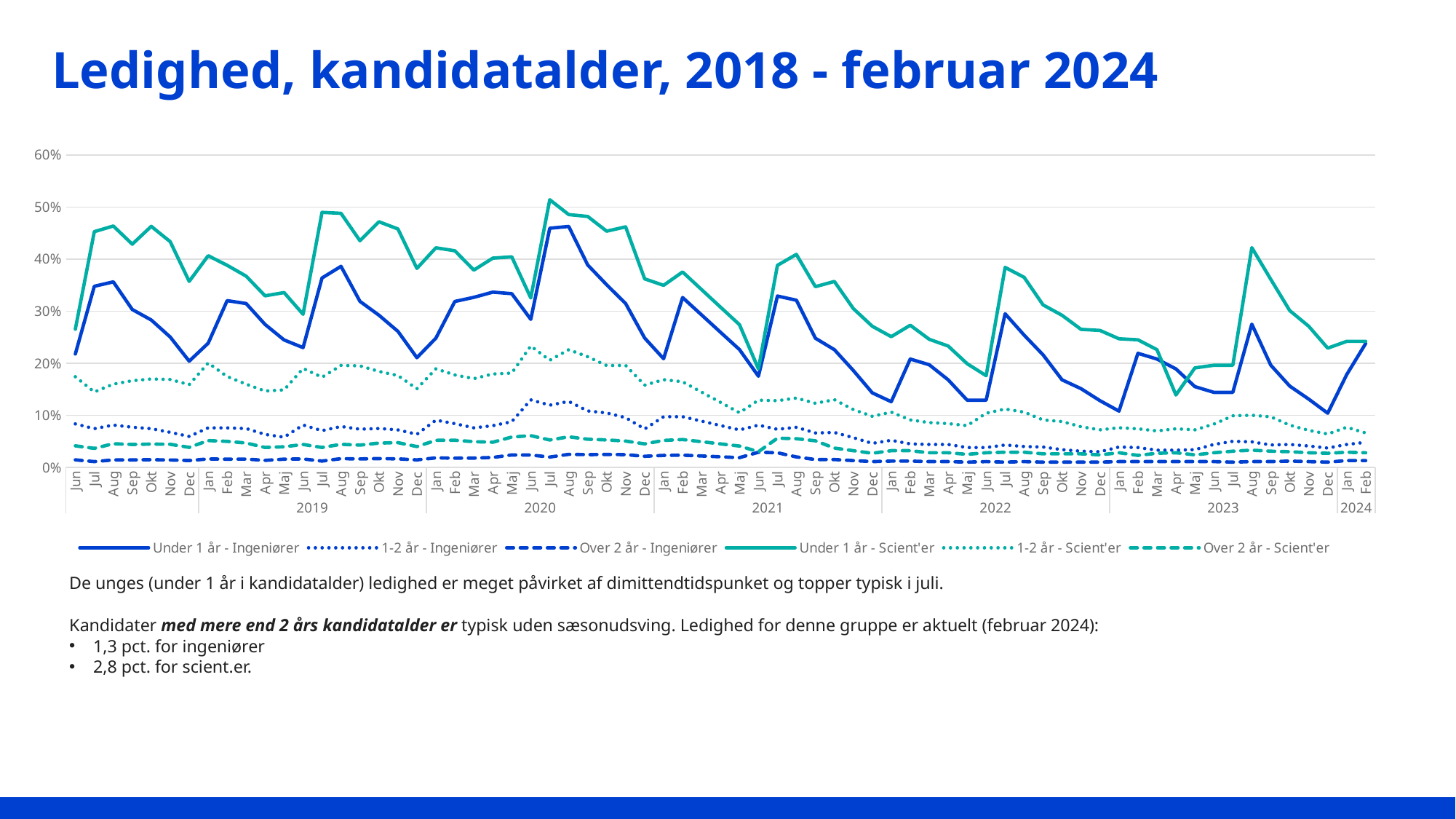
In Aug 2023, which is larger: Under 1 år - Scient'er or Under 1 år - Ingeniører? Under 1 år - Scient'er Which series stays lowest across the whole chart? Over 2 år - Ingeniører Does the Under 1 år - Scient'er line rise or fall from Aug 2023 to Dec 2023? Fall How many series does the legend list? 6 Is the value for Under 1 år - Ingeniører in Jul 2020 greater or less than 40%? greater What is the title of the chart? Ledighed, kandidatalder, 2018 - februar 2024 Is the value for Under 1 år - Scient'er in Jul 2020 greater or less than 40%? greater According to the slide text, what is the unemployment rate for ingeniører with more than 2 years of kandidatalder in February 2024? 1,3 pct. Is the value for Over 2 år - Ingeniører in Jul 2020 greater or less than 10%? less What kind of chart is shown on the slide? Line chart Which series reaches the highest value on the chart? Under 1 år - Scient'er